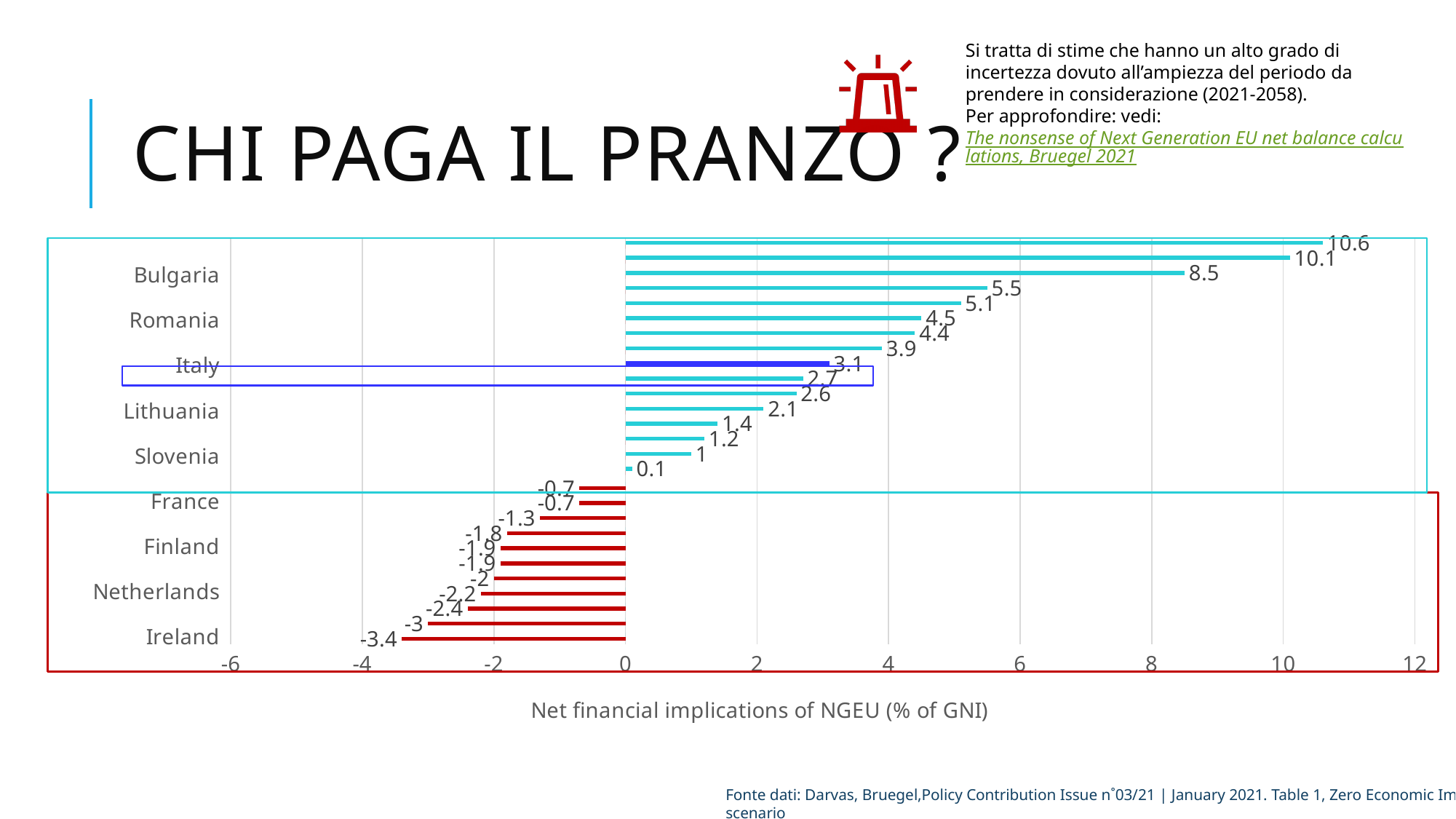
What is the difference between the values for Bulgaria and Romania? 4 Which labelled country has the lowest value? Ireland What is the value for Ireland? -3.4 What is the value for Romania? 4.5 What is the title of the horizontal axis? Net financial implications of NGEU (% of GNI) Which is larger, the value for Italy or the value for Lithuania? Italy What kind of chart is shown on the slide? Bar chart What is the highest value shown on the chart? 10.6 What is the value for Italy? 3.1 What is the value for Slovenia? 1 What is the value for Bulgaria? 8.5 What is the value for Netherlands? -2.2